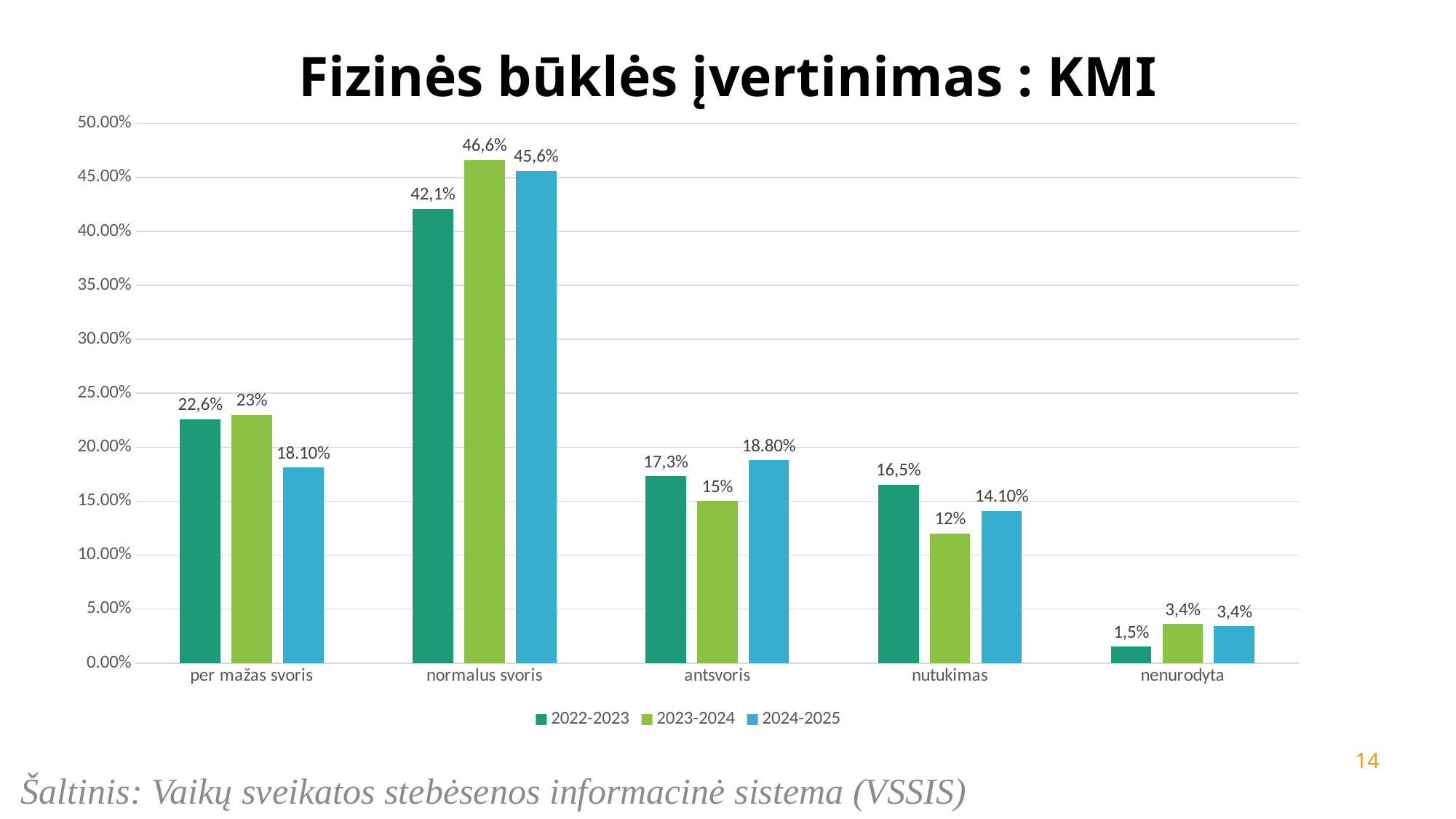
What is the value for normalus svoris in the 2023-2024 series? 46,6% What is the value for antsvoris in the 2024-2025 series? 18.80% Which category has the lowest value in the 2023-2024 series? nenurodyta How many series does the legend list? 3 Which category has the highest value in the 2024-2025 series? normalus svoris What is the difference between the 2023-2024 and 2022-2023 values for normalus svoris? 4,5% What is the value for nutukimas in the 2022-2023 series? 16,5% What is the value for nenurodyta in the 2022-2023 series? 1,5% How many categories are shown on the x axis? 5 What is the title of the chart? Fizinės būklės įvertinimas : KMI What kind of chart is shown on the slide? bar chart Which is larger for nutukimas: the 2022-2023 value or the 2024-2025 value? 2022-2023